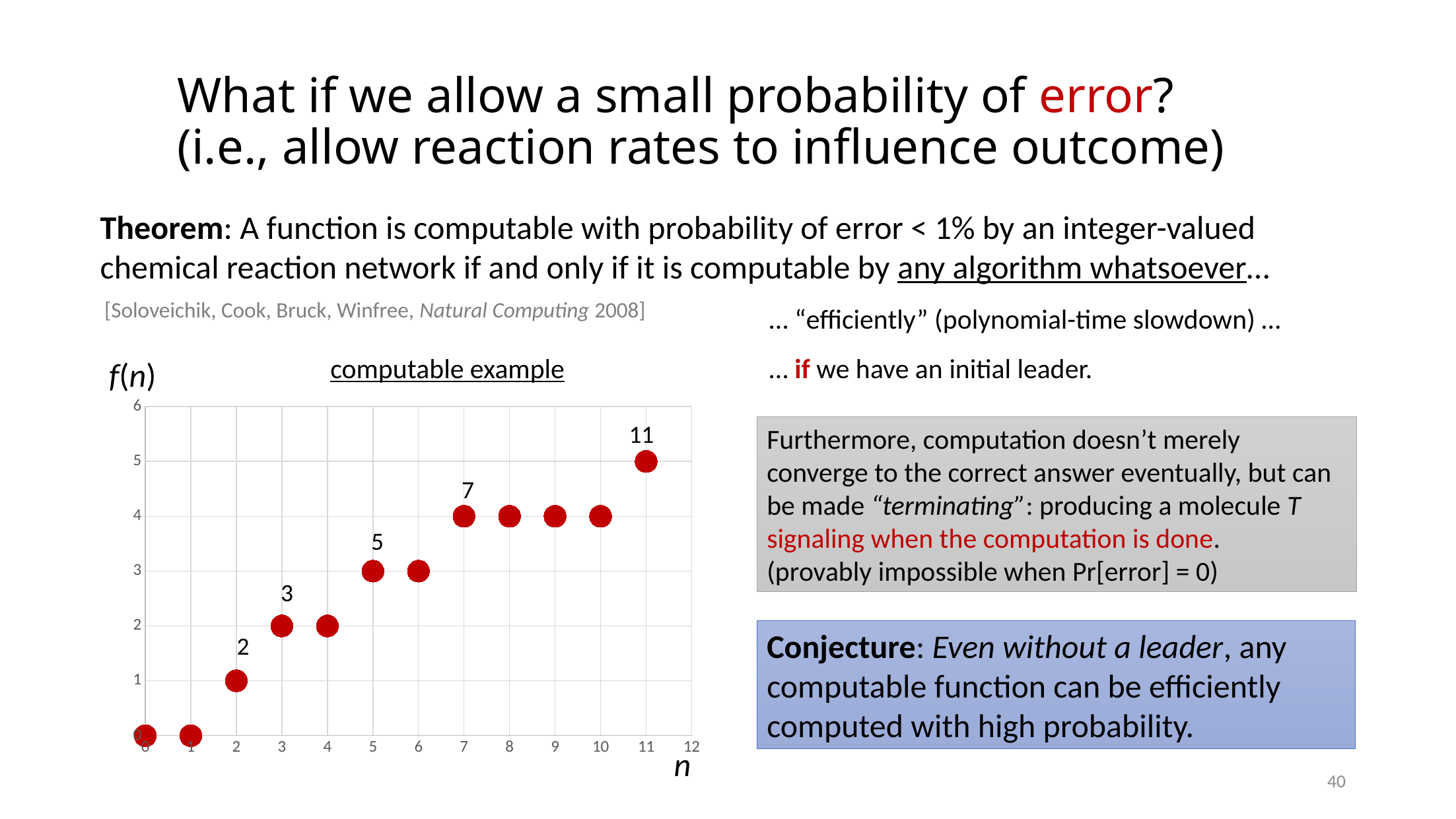
What is the value of f(n) at n = 7? 4 How many data points are plotted in the chart? 12 What kind of chart is shown on the slide? scatter plot What is the value of f(n) at n = 5? 3 What is the title of the chart? computable example What is the difference between f(n) at n = 11 and f(n) at n = 2? 4 What data label is printed next to the highest point in the chart? 11 At which value of n is f(n) highest? 11 What is the value of f(n) at n = 2? 1 Which is larger, f(n) at n = 11 or at n = 7? n = 11 What is the value of f(n) at n = 11? 5 Do the values of f(n) generally rise or fall as n increases? rise